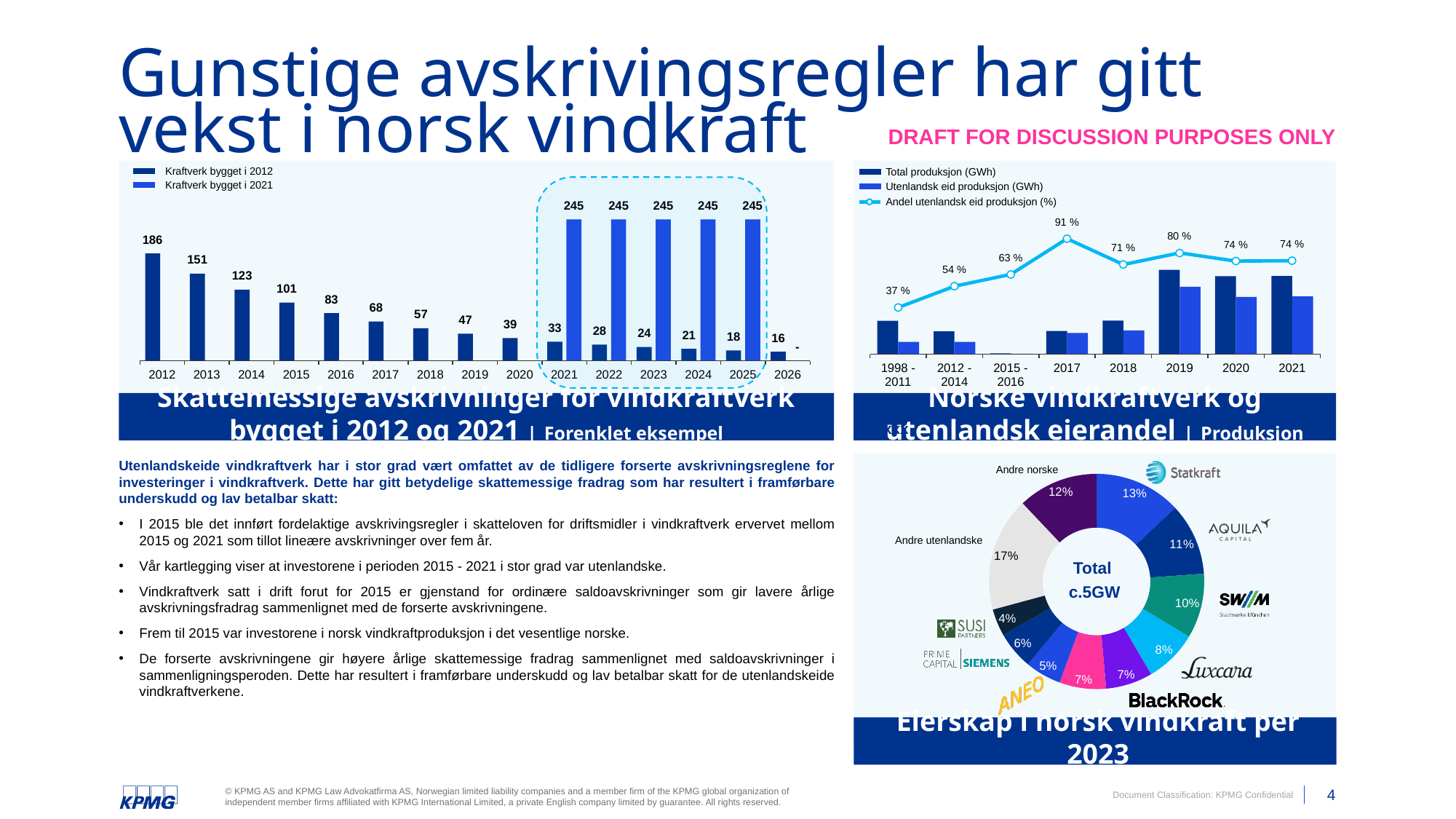
How many series does the legend of the chart 'Norske vindkraftverk og utenlandsk eierandel' list? 3 In the chart 'Norske vindkraftverk og utenlandsk eierandel', what is the 'Andel utenlandsk eid produksjon (%)' for 2017? 91 % In the chart 'Norske vindkraftverk og utenlandsk eierandel', which period has the lowest 'Andel utenlandsk eid produksjon (%)'? 1998 - 2011 In the chart 'Eierskap i norsk vindkraft per 2023', which is larger: the share for 'Andre utenlandske' or the share for 'Andre norske'? Andre utenlandske In the chart 'Skattemessige avskrivninger for vindkraftverk bygget i 2012 og 2021', what is the value for 'Kraftverk bygget i 2012' in 2012? 186 In the chart 'Skattemessige avskrivninger for vindkraftverk bygget i 2012 og 2021', what is the difference between the 'Kraftverk bygget i 2012' values for 2012 and 2013? 35 How many series does the legend of the chart 'Skattemessige avskrivninger for vindkraftverk bygget i 2012 og 2021' list? 2 In the chart 'Eierskap i norsk vindkraft per 2023', what share does Statkraft hold? 13% In the chart 'Skattemessige avskrivninger for vindkraftverk bygget i 2012 og 2021', what is the value for 'Kraftverk bygget i 2021' in 2023? 245 What kind of chart is 'Eierskap i norsk vindkraft per 2023'? doughnut chart In the chart 'Skattemessige avskrivninger for vindkraftverk bygget i 2012 og 2021', which year has the lowest value for 'Kraftverk bygget i 2012'? 2026 In the chart 'Skattemessige avskrivninger for vindkraftverk bygget i 2012 og 2021', do the 'Kraftverk bygget i 2012' values rise or fall from 2012 to 2026? fall